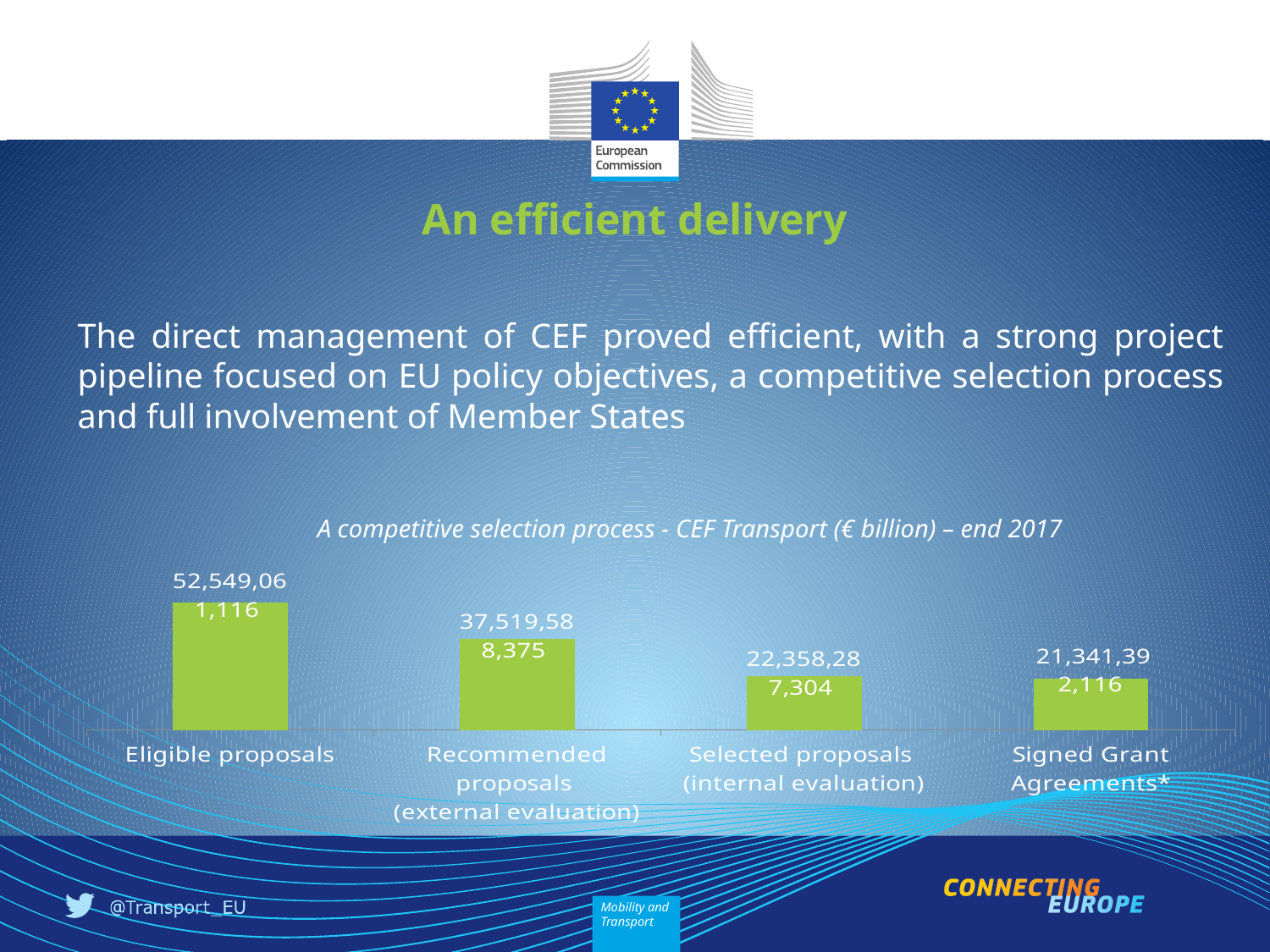
What is the value printed above the bar for Signed Grant Agreements*? 21,341,39 What is the title of the chart? A competitive selection process - CEF Transport (€ billion) – end 2017 What number is printed inside the bar for Recommended proposals (external evaluation)? 8,375 What number is printed inside the bar for Signed Grant Agreements*? 2,116 Which category has the shortest bar? Signed Grant Agreements* What is the value printed above the bar for Eligible proposals? 52,549,06 Which category has the tallest bar? Eligible proposals How many categories are shown on the x axis of the chart? 4 What is the value printed above the bar for Recommended proposals (external evaluation)? 37,519,58 Do the bar values rise or fall from left to right across the categories? fall What is the value printed above the bar for Selected proposals (internal evaluation)? 22,358,28 What kind of chart is shown on the slide? bar chart